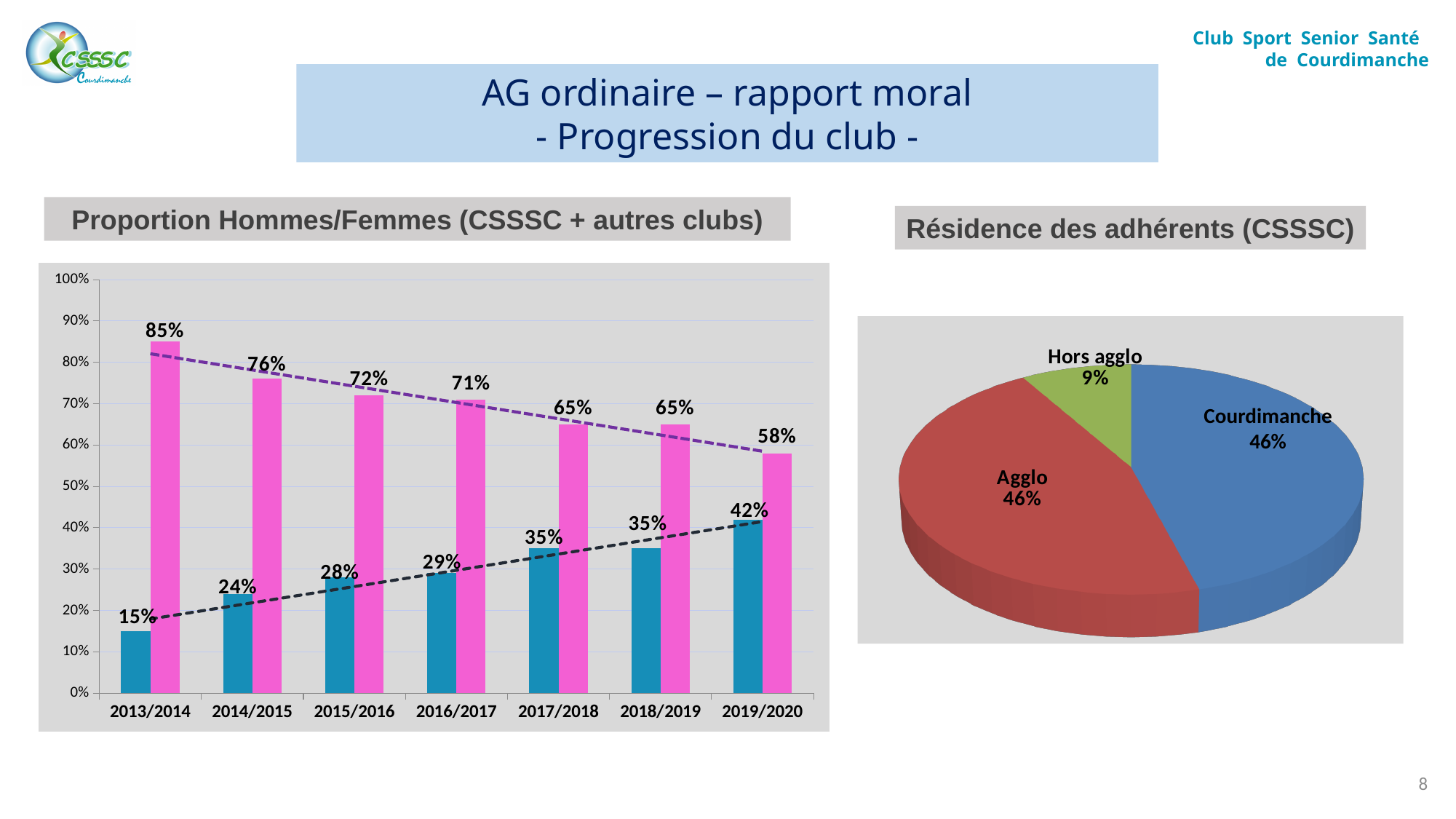
In the 'Proportion Hommes/Femmes' chart, what is the value of the pink bar for 2013/2014? 85% In the 'Proportion Hommes/Femmes' chart, do the blue bars rise or fall from 2013/2014 to 2019/2020? rise How many slices does the 'Résidence des adhérents (CSSSC)' pie chart have? 3 In the 'Résidence des adhérents (CSSSC)' pie chart, which category has the smallest slice? Hors agglo In the 'Proportion Hommes/Femmes' chart, what is the value of the blue bar for 2019/2020? 42% What kind of chart is the 'Proportion Hommes/Femmes' chart? bar chart In the 'Proportion Hommes/Femmes' chart, which year has the highest pink bar? 2013/2014 In the 'Résidence des adhérents (CSSSC)' pie chart, what share is Hors agglo? 9% How many years are shown on the x axis of the 'Proportion Hommes/Femmes' chart? 7 In the 'Proportion Hommes/Femmes' chart, what is the difference between the pink bar and the blue bar in 2019/2020? 16% In the 'Proportion Hommes/Femmes' chart, which year has the lowest blue bar? 2013/2014 In the 'Proportion Hommes/Femmes' chart, what is the value of the blue bar for 2016/2017? 29%